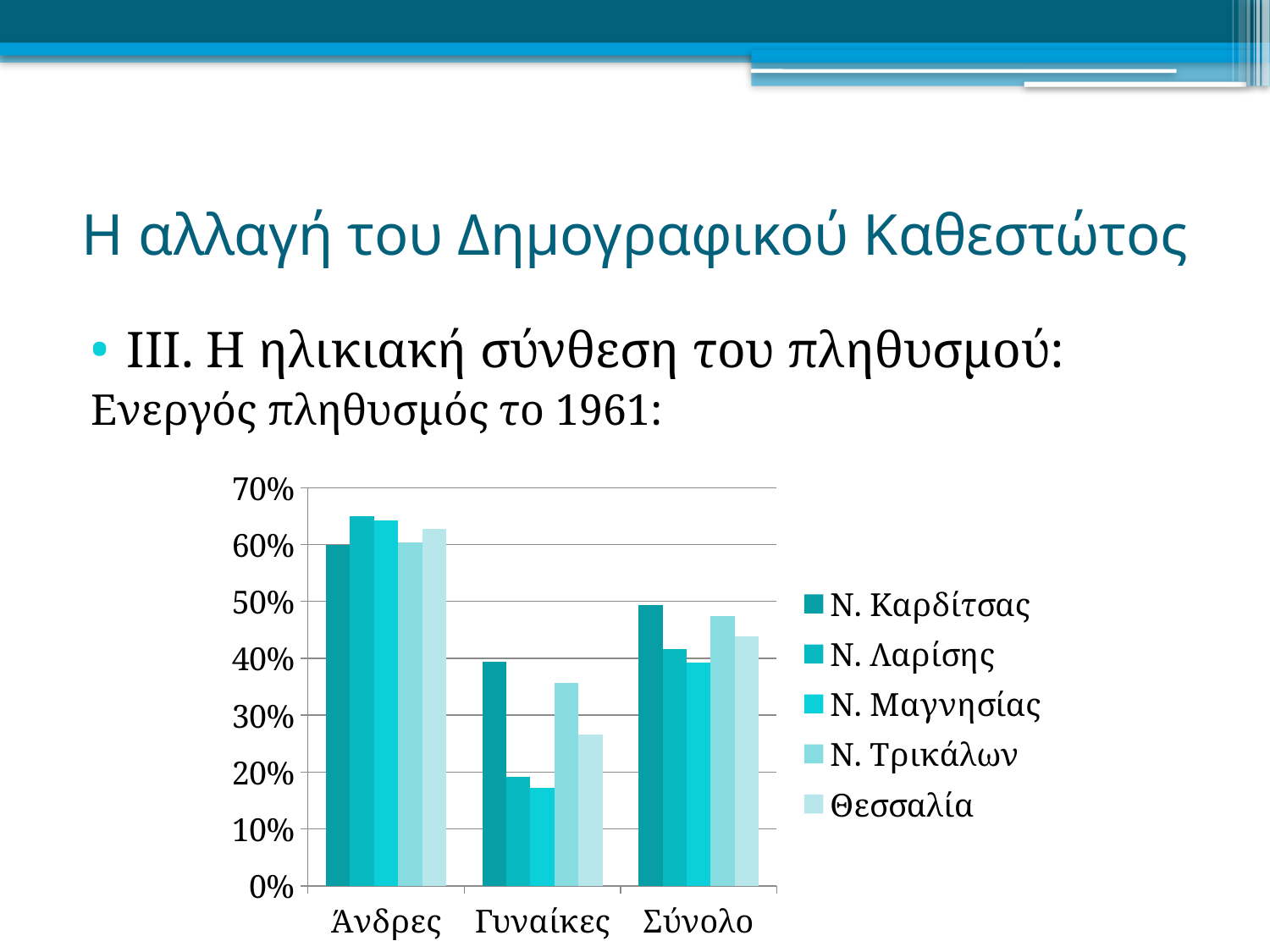
In the Γυναίκες category, which is larger: the value for Ν. Τρικάλων or the value for Θεσσαλία? Ν. Τρικάλων Which series has the lowest value in the Γυναίκες category? Ν. Μαγνησίας What kind of chart is shown on the slide? bar chart Which series has the highest value in the Σύνολο category? Ν. Καρδίτσας Is the value for Ν. Λαρίσης in the Άνδρες category greater or less than 60%? greater Which series is listed last in the chart legend? Θεσσαλία How many categories are shown on the x axis of the chart? 3 How many series does the chart legend list? 5 Is the value for Ν. Μαγνησίας in the Γυναίκες category greater or less than 20%? less Is the value for Θεσσαλία in the Σύνολο category greater or less than 40%? greater Which category has the lowest values across all series: Άνδρες, Γυναίκες or Σύνολο? Γυναίκες